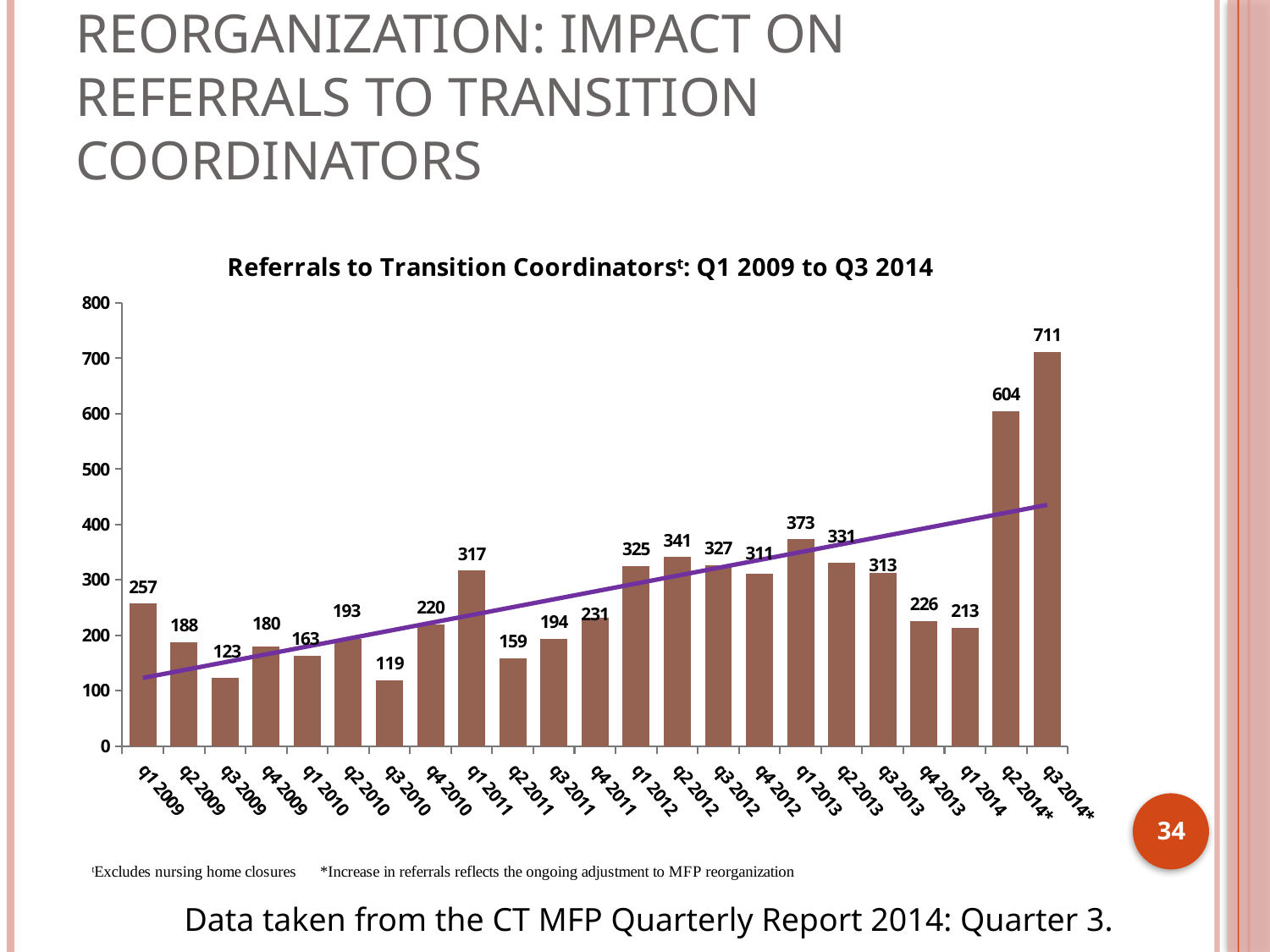
Which quarter has the lowest number of referrals? Q3 2010 What kind of chart is this? bar chart What is the difference between the values for Q1 2011 and Q2 2011? 158 What is the value for Q2 2014*? 604 Is the value for Q1 2014 greater or less than 300? less What is the value for Q1 2013? 373 What is the value for Q1 2009? 257 Which is larger, the value for Q2 2012 or the value for Q3 2012? Q2 2012 How many quarters are shown on the x axis? 23 What is the difference between the values for Q3 2014* and Q2 2014*? 107 Which quarter has the highest number of referrals? Q3 2014* What is the title of the chart? Referrals to Transition Coordinatorsᵗ: Q1 2009 to Q3 2014